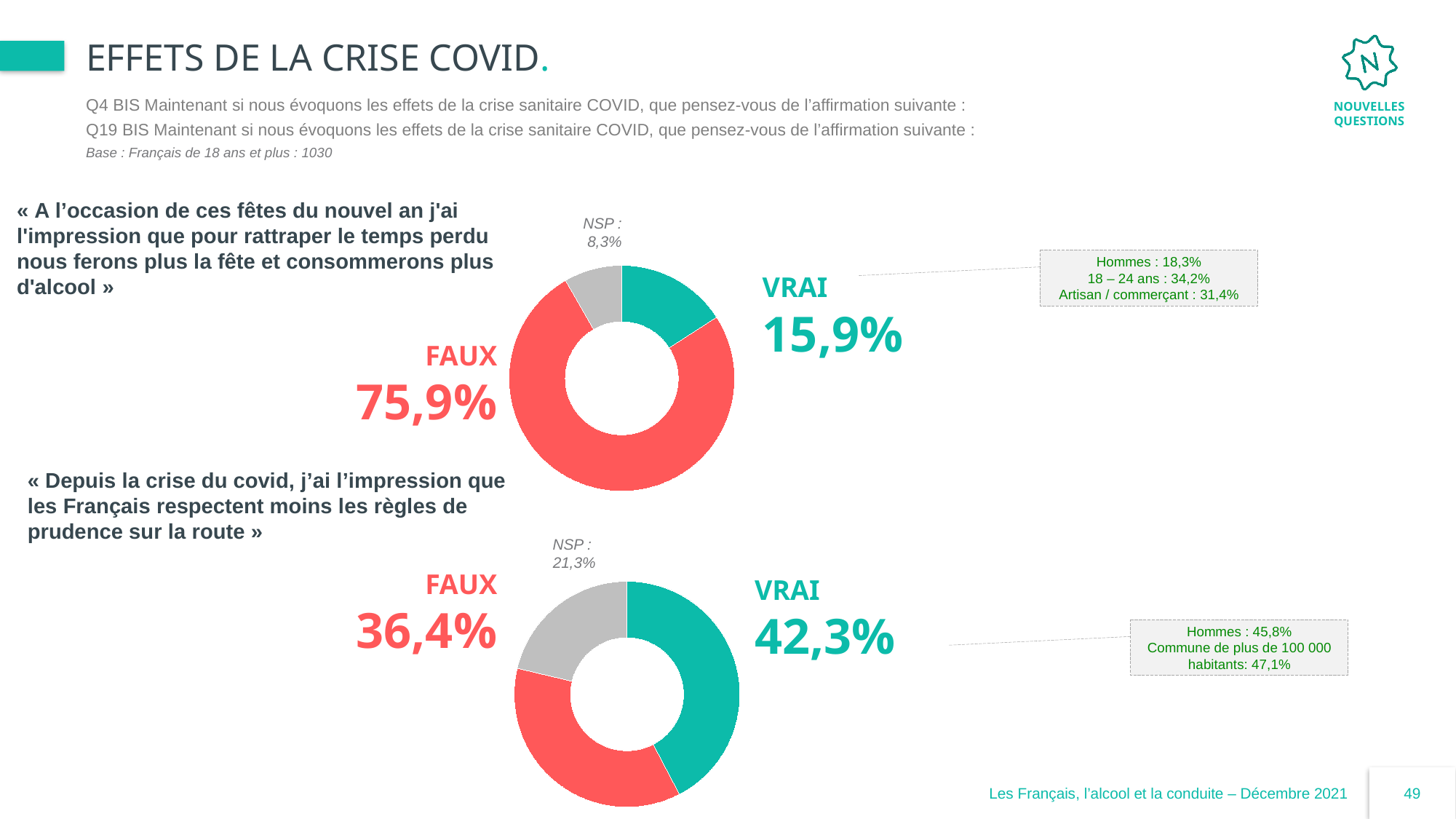
How many slices does each donut chart on the slide have? 3 In the top donut chart, what percentage answered VRAI? 15,9% In the top donut chart, which response has the largest share? FAUX What type of chart is used on this slide? Donut (pie) chart In the bottom donut chart, which response has the smallest share? NSP In the bottom donut chart, which is larger: VRAI or FAUX? VRAI In the bottom donut chart, what percentage answered FAUX? 36,4% In the bottom donut chart, what is the NSP share? 21,3% In the top donut chart, what is the NSP share? 8,3% In the bottom donut chart (about respecting road safety rules since covid), what percentage answered VRAI? 42,3% In the top donut chart, what is the difference in percentage points between FAUX and VRAI? 60 points In the top donut chart (about the New Year celebrations statement), what percentage answered FAUX? 75,9%